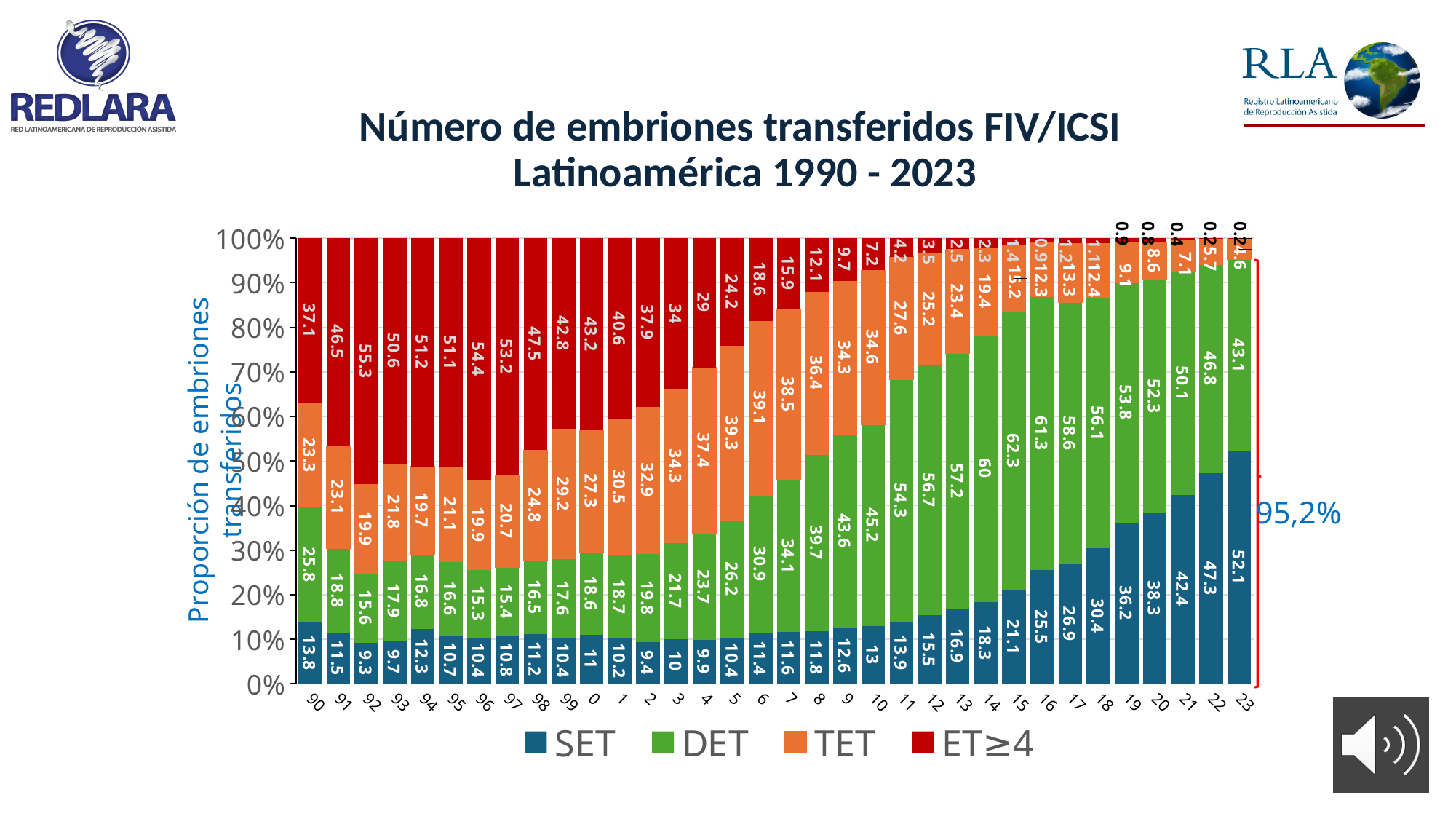
Which year has the highest ET≥4 value? 92 What is the SET value for 23? 52.1 Does the SET share rise or fall from 15 to 23? Rise What is the difference between the SET value for 23 and the SET value for 90? 38.3 How many series does the legend list? 4 What is the ET≥4 value for 90? 37.1 What is the TET value for 5? 39.3 What is the combined SET and DET value for 23? 95.2 How many years are shown on the x axis? 34 Which year has the highest SET value? 23 In year 5, which is larger, DET or TET? TET What kind of chart is shown? Stacked bar chart